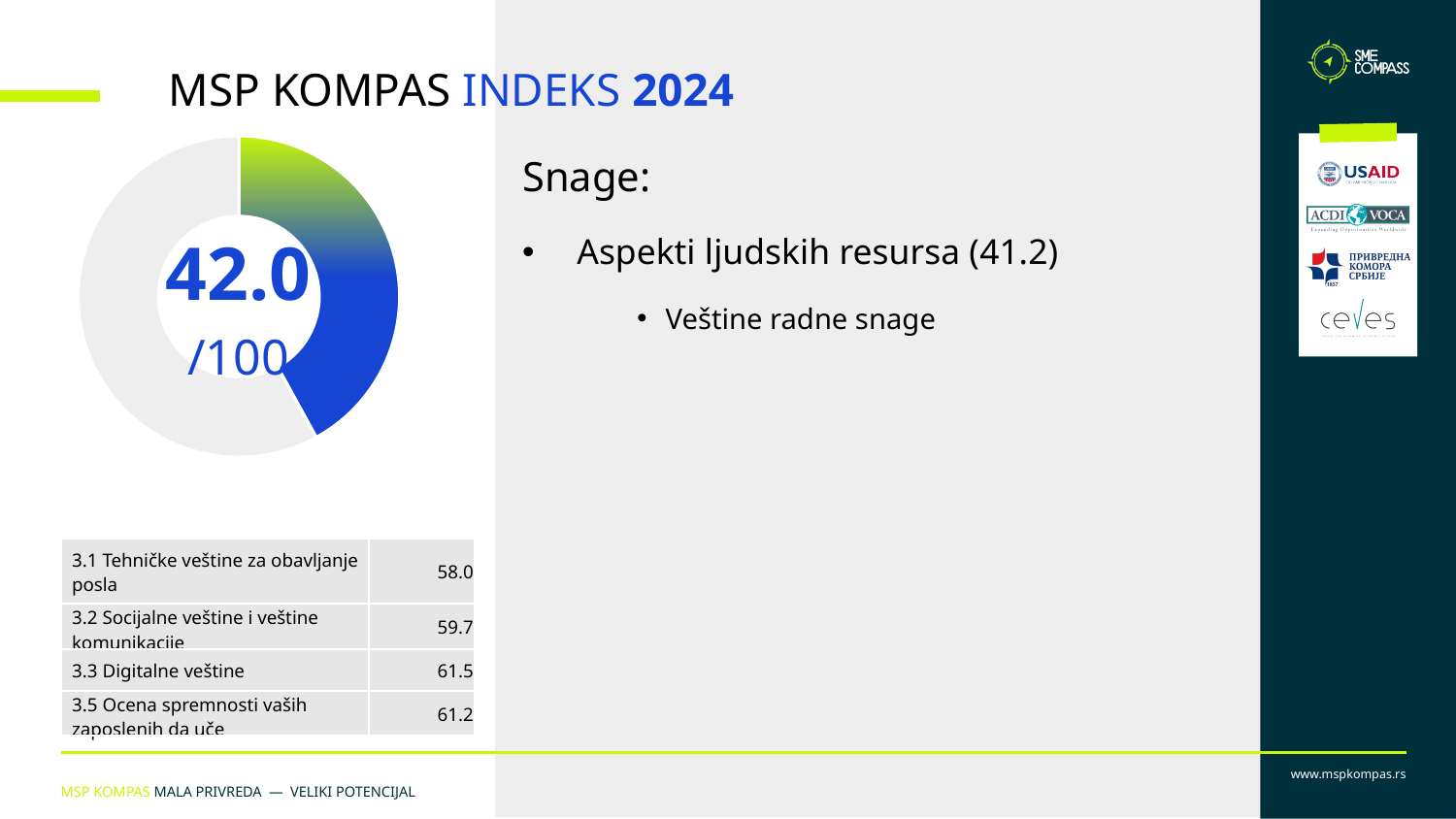
Out of what maximum is the index value in the donut chart expressed? /100 How many segments does the donut chart have? 2 What share of the full circle does the filled portion of the donut chart represent, given the value 42.0 out of 100? 42% What value is displayed in the centre of the donut chart? 42.0 What kind of chart is shown on the left of the slide? Donut chart What is the title shown above the donut chart on the slide? MSP KOMPAS INDEKS 2024 Is the index value shown in the donut chart greater or less than 50? less Is the filled portion of the donut chart larger or smaller than the unfilled (grey) portion? smaller